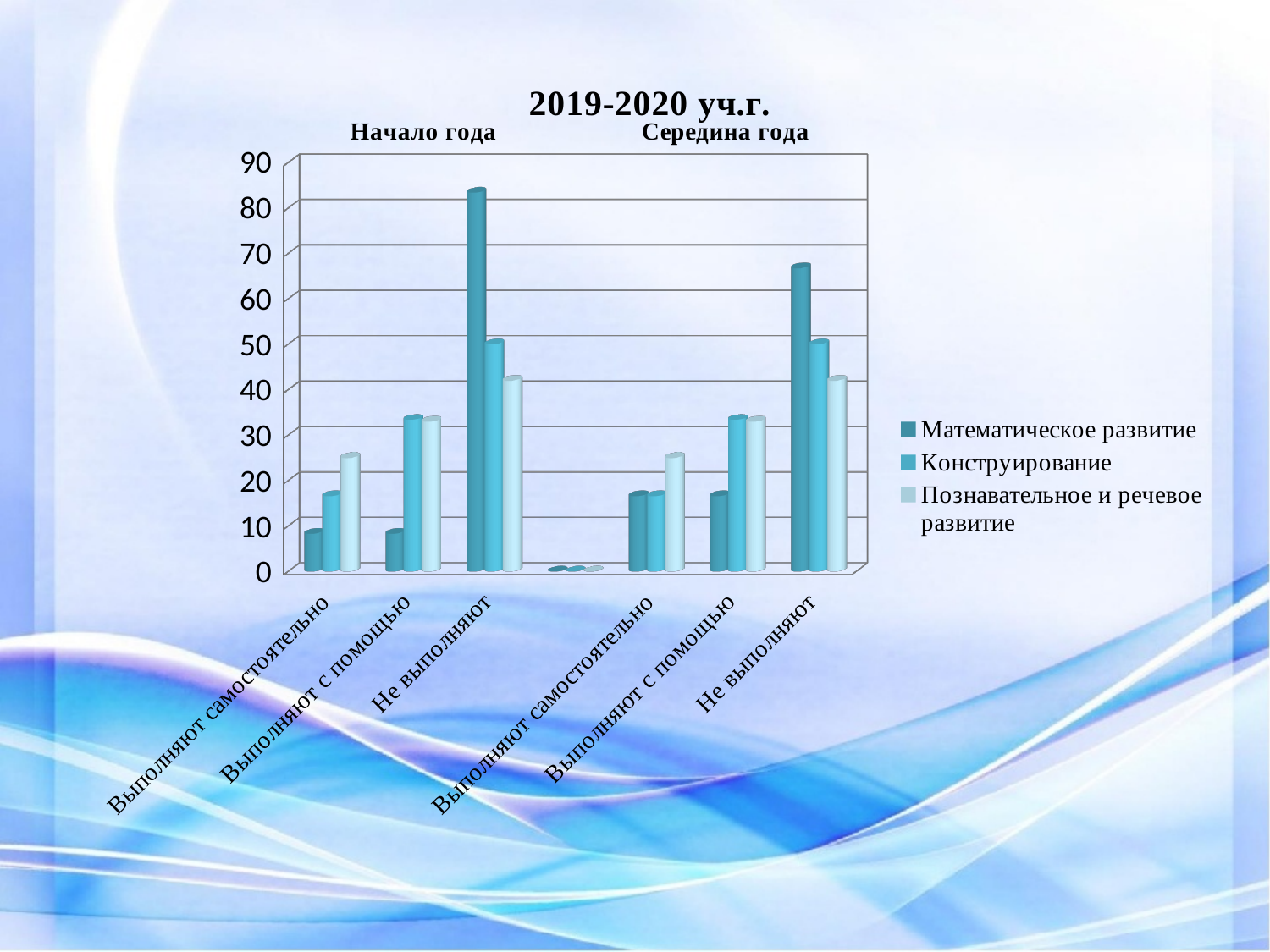
For Не выполняют at Начало года, which is larger: Математическое развитие or Конструирование? Математическое развитие Which category has the tallest Математическое развитие bar? Не выполняют (Начало года) How many series does the legend list? 3 Is the Познавательное и речевое развитие value for Не выполняют at Середина года greater or less than 50? less Is the Конструирование value for Выполняют самостоятельно at Начало года greater or less than 20? less Is the Математическое развитие value for Не выполняют at Начало года greater or less than 70? greater For Выполняют самостоятельно at Начало года, which is larger: Познавательное и речевое развитие or Математическое развитие? Познавательное и речевое развитие Which series are listed in the legend? Математическое развитие, Конструирование, Познавательное и речевое развитие How many labelled categories are shown along the x axis? 6 What is the title of the chart? 2019-2020 уч.г. What kind of chart is shown on the slide? bar chart